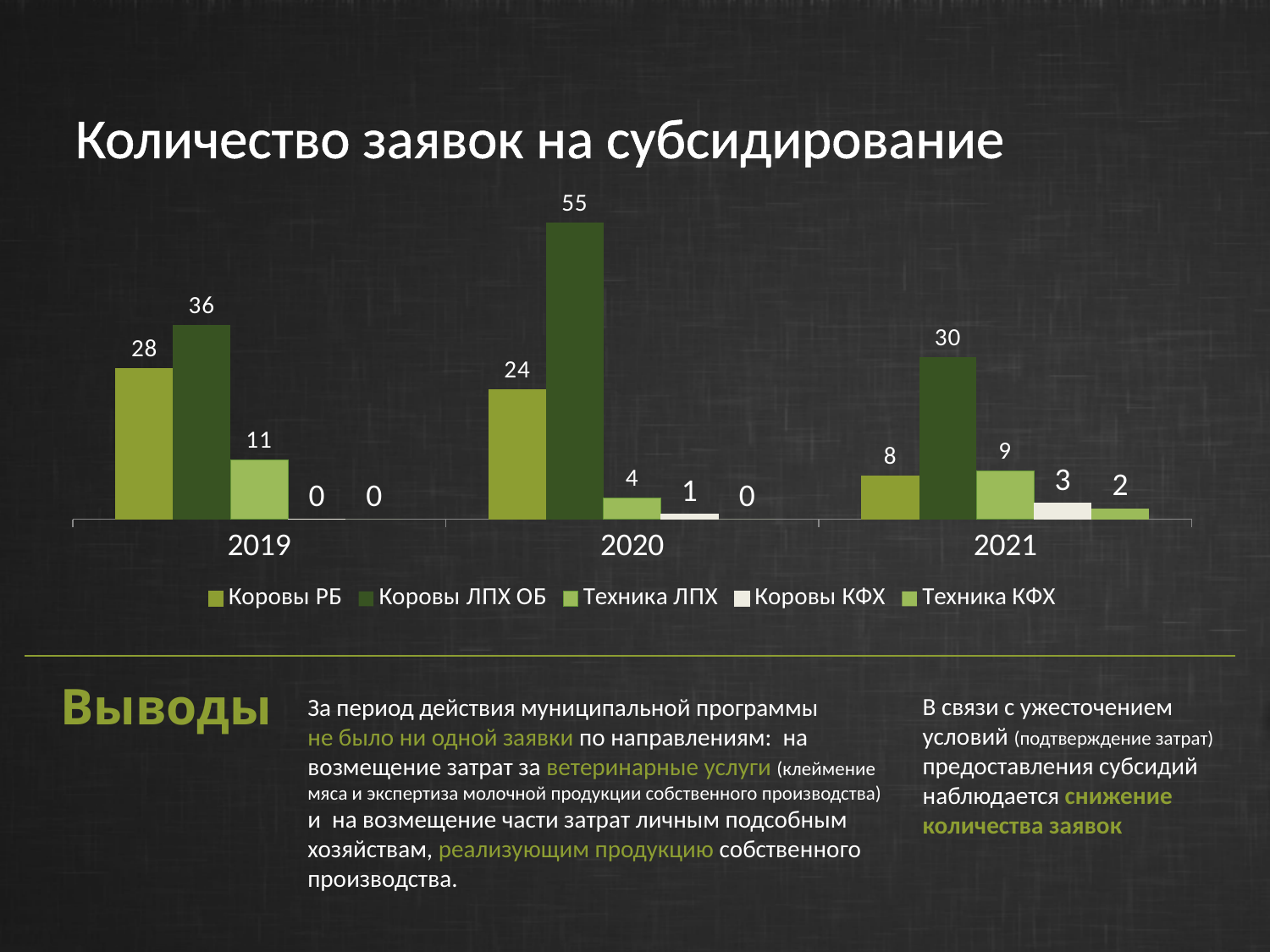
How many series does the legend list? 5 Does the value for Коровы РБ rise or fall from 2019 to 2021? Fall How many years are shown on the x axis? 3 What is the value for Коровы КФХ in 2020? 1 Which is larger in 2021: Коровы РБ or Техника ЛПХ? Техника ЛПХ What is the value for Коровы ЛПХ ОБ in 2020? 55 What is the value for Техника ЛПХ in 2021? 9 In which year is the value for Коровы ЛПХ ОБ highest? 2020 In which year is the value for Коровы РБ lowest? 2021 What kind of chart is shown on the slide? Bar chart What is the difference between Коровы ЛПХ ОБ and Коровы РБ in 2020? 31 What is the value for Коровы РБ in 2019? 28